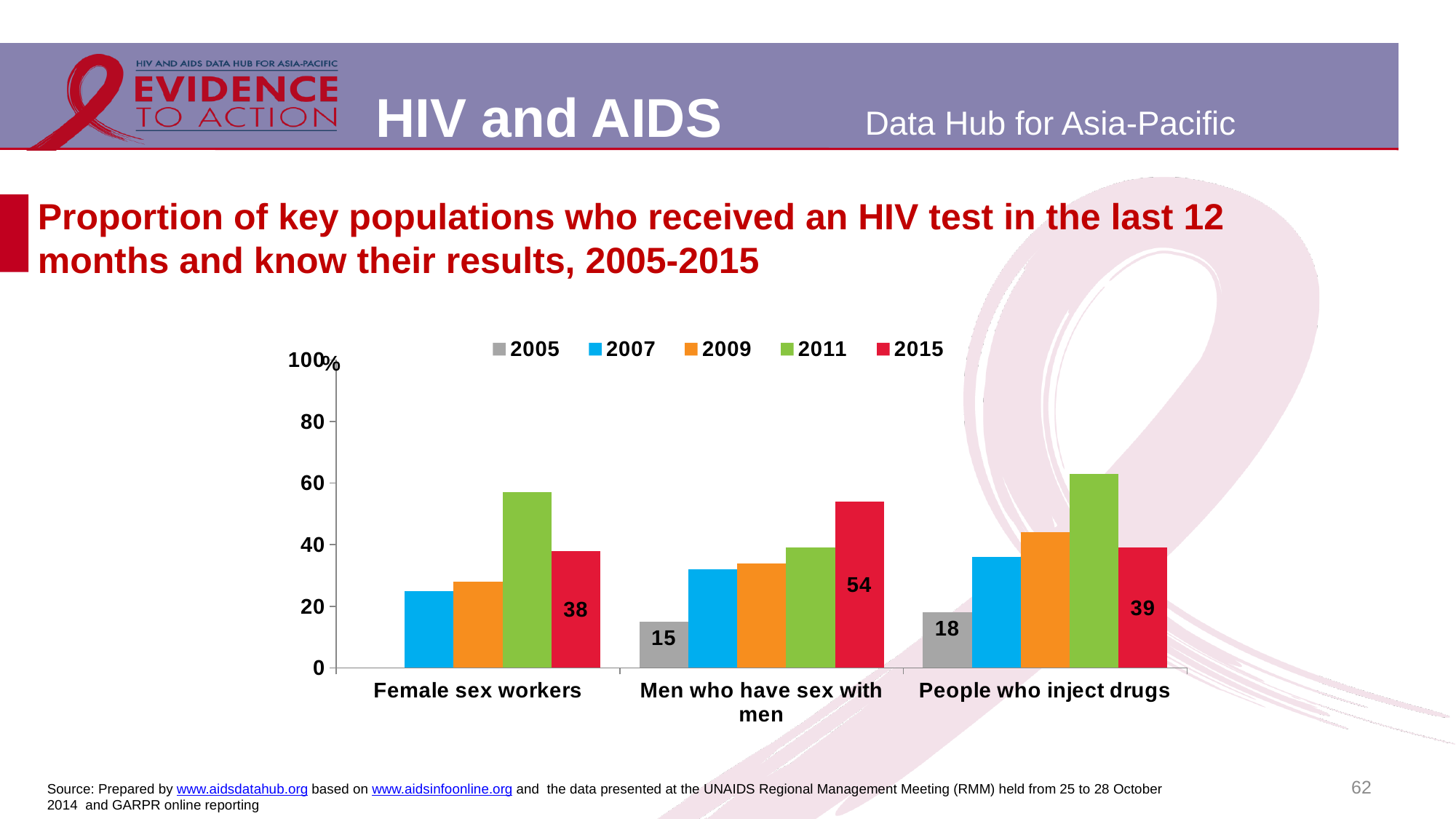
What kind of chart is shown on the slide? Bar chart By how much did the value for People who inject drugs increase from 2005 to 2015? 21 What is the value for Men who have sex with men in 2015? 54 What is the difference between the 2015 values for Men who have sex with men and Female sex workers? 16 What is the value for Female sex workers in 2015? 38 Which category has the highest value in 2015? Men who have sex with men Is the 2011 value for Female sex workers greater or less than 40? greater How many series does the legend list? 5 What is the value for People who inject drugs in 2005? 18 Which is larger: the 2005 value for People who inject drugs or the 2005 value for Men who have sex with men? People who inject drugs Is the 2007 value for Female sex workers greater or less than 40? less What is the value for Men who have sex with men in 2005? 15